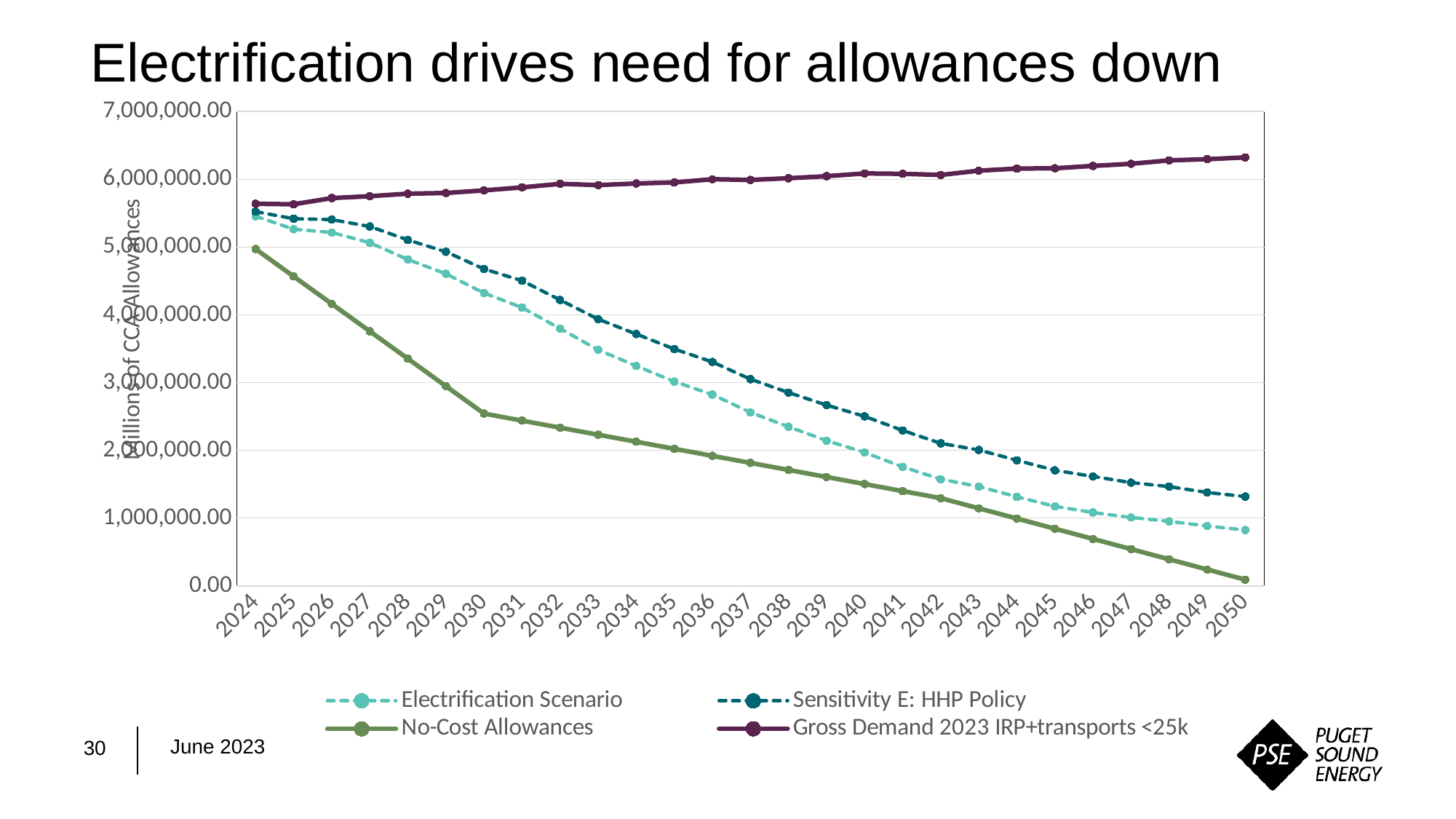
How many years are plotted along the x axis? 27 Is the value for No-Cost Allowances in 2030 greater or less than 3,000,000.00? less In 2040, which is larger: Sensitivity E: HHP Policy or Electrification Scenario? Sensitivity E: HHP Policy Is the value for Gross Demand 2023 IRP+transports <25k in 2050 greater or less than 6,000,000.00? greater Which series has the highest value in 2050? Gross Demand 2023 IRP+transports <25k What kind of chart is shown on the slide? Line chart Which series has the lowest value in 2050? No-Cost Allowances How many series does the legend list? 4 Does the No-Cost Allowances series rise or fall from 2024 to 2050? Falls What is the title of the slide's chart? Electrification drives need for allowances down Does the Gross Demand 2023 IRP+transports <25k series rise or fall from 2024 to 2050? Rises Is the value for Electrification Scenario in 2050 greater or less than 1,000,000.00? less